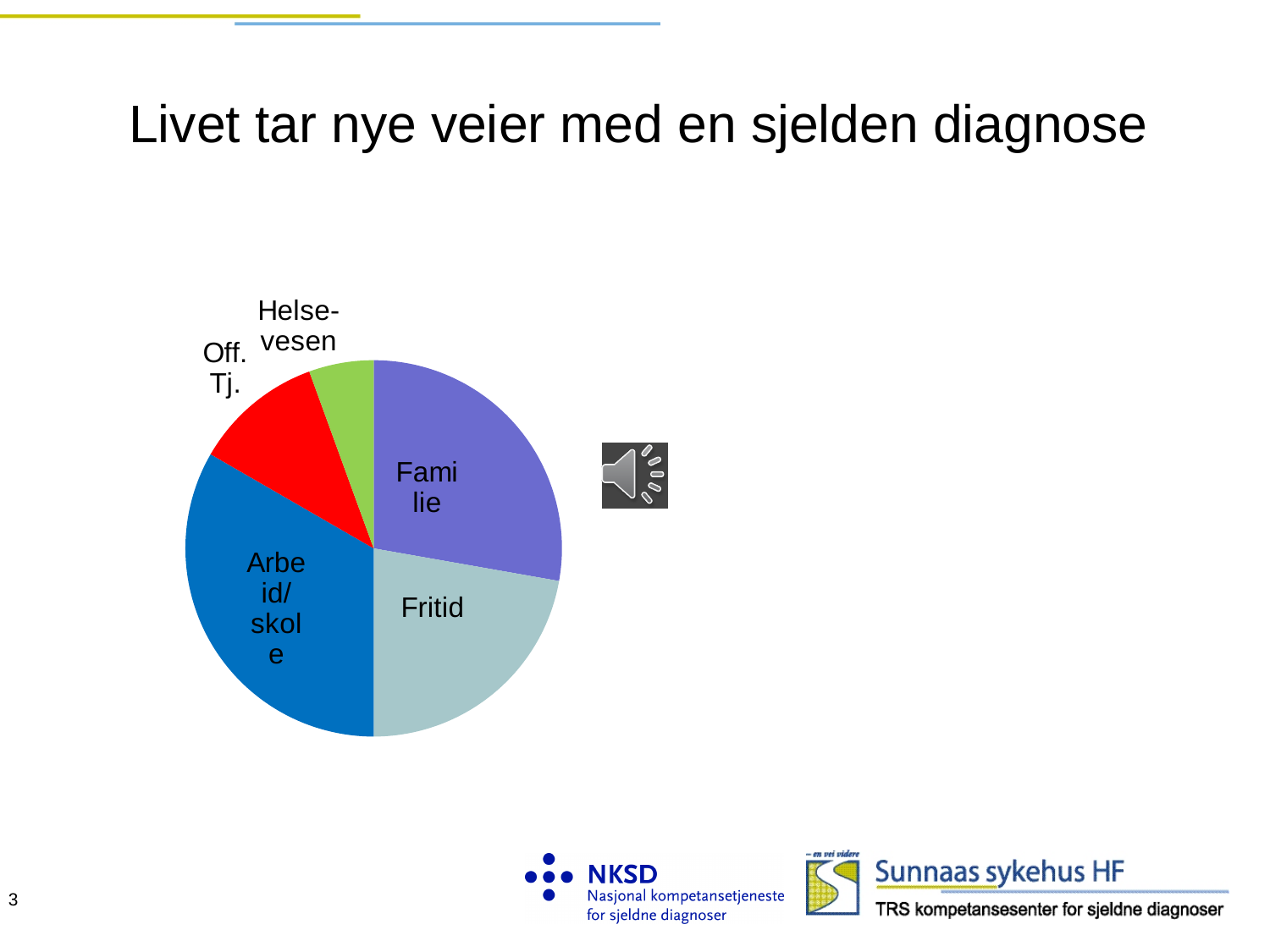
How many slices does the pie chart have? 5 What kind of chart is shown on the slide? pie chart Which slice of the pie chart is the largest? Arbeid/skole Which slice is larger, Arbeid/skole or Fritid? Arbeid/skole Which slice is larger, Arbeid/skole or Familie? Arbeid/skole Which slice of the pie chart is the smallest? Helsevesen What colour is the Helsevesen slice of the pie chart? green What colour is the Off. Tj. slice of the pie chart? red Which slice is larger, Familie or Helsevesen? Familie